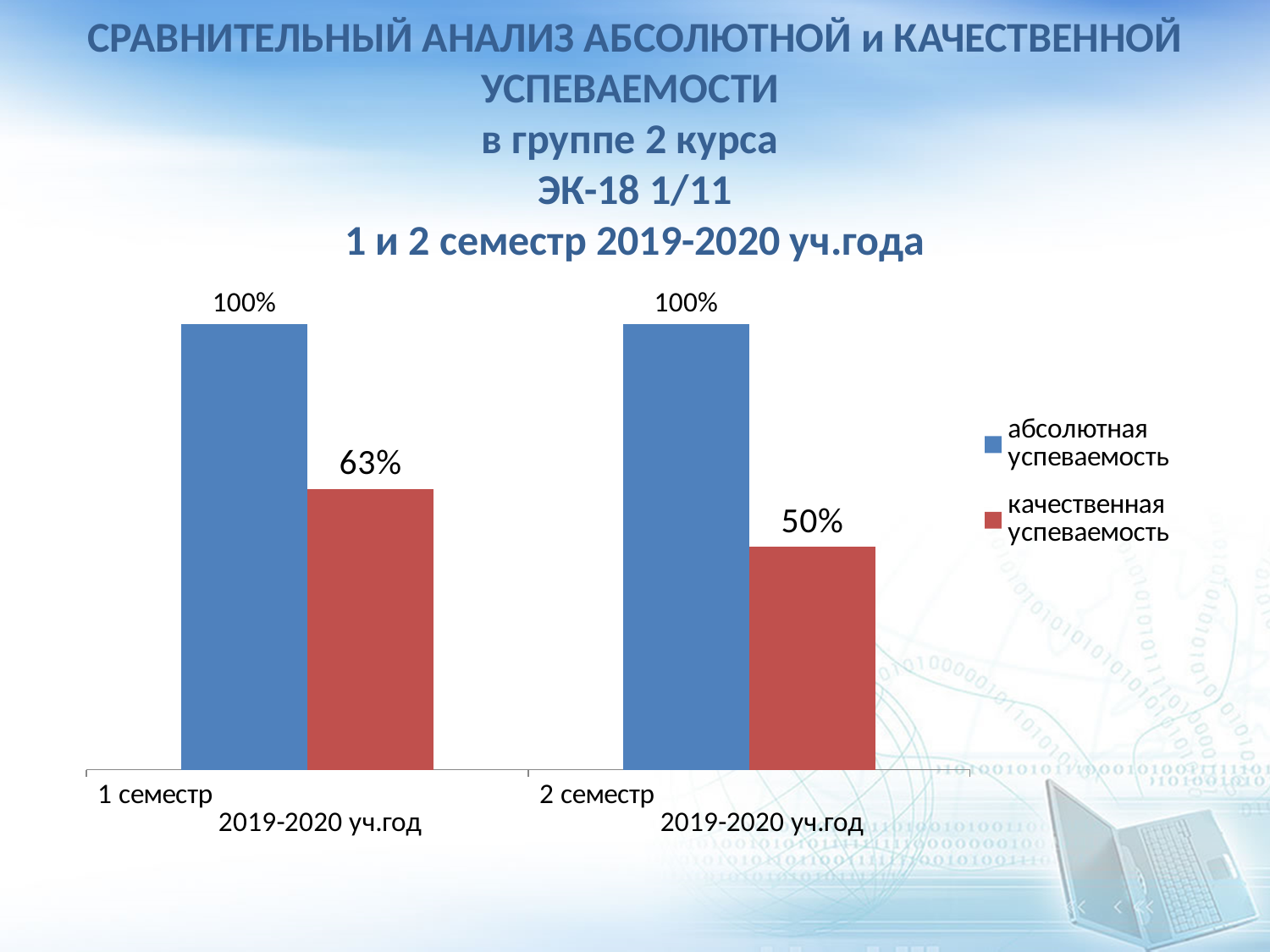
What is the difference between абсолютная успеваемость and качественная успеваемость in 2 семестр 2019-2020 уч.год? 50% What is the value of качественная успеваемость for 1 семестр 2019-2020 уч.год? 63% What is the value of абсолютная успеваемость for 2 семестр 2019-2020 уч.год? 100% What is the difference between качественная успеваемость in 1 семестр and 2 семестр? 13% In which semester is качественная успеваемость lowest? 2 семестр 2019-2020 уч.год How many series does the legend list? 2 How many categories (semesters) are shown on the x axis? 2 What is the value of качественная успеваемость for 2 семестр 2019-2020 уч.год? 50% What kind of chart is shown on the slide? bar chart What is the value of абсолютная успеваемость for 1 семестр 2019-2020 уч.год? 100% Which is larger in 1 семестр: абсолютная успеваемость or качественная успеваемость? абсолютная успеваемость In which semester is качественная успеваемость highest? 1 семестр 2019-2020 уч.год